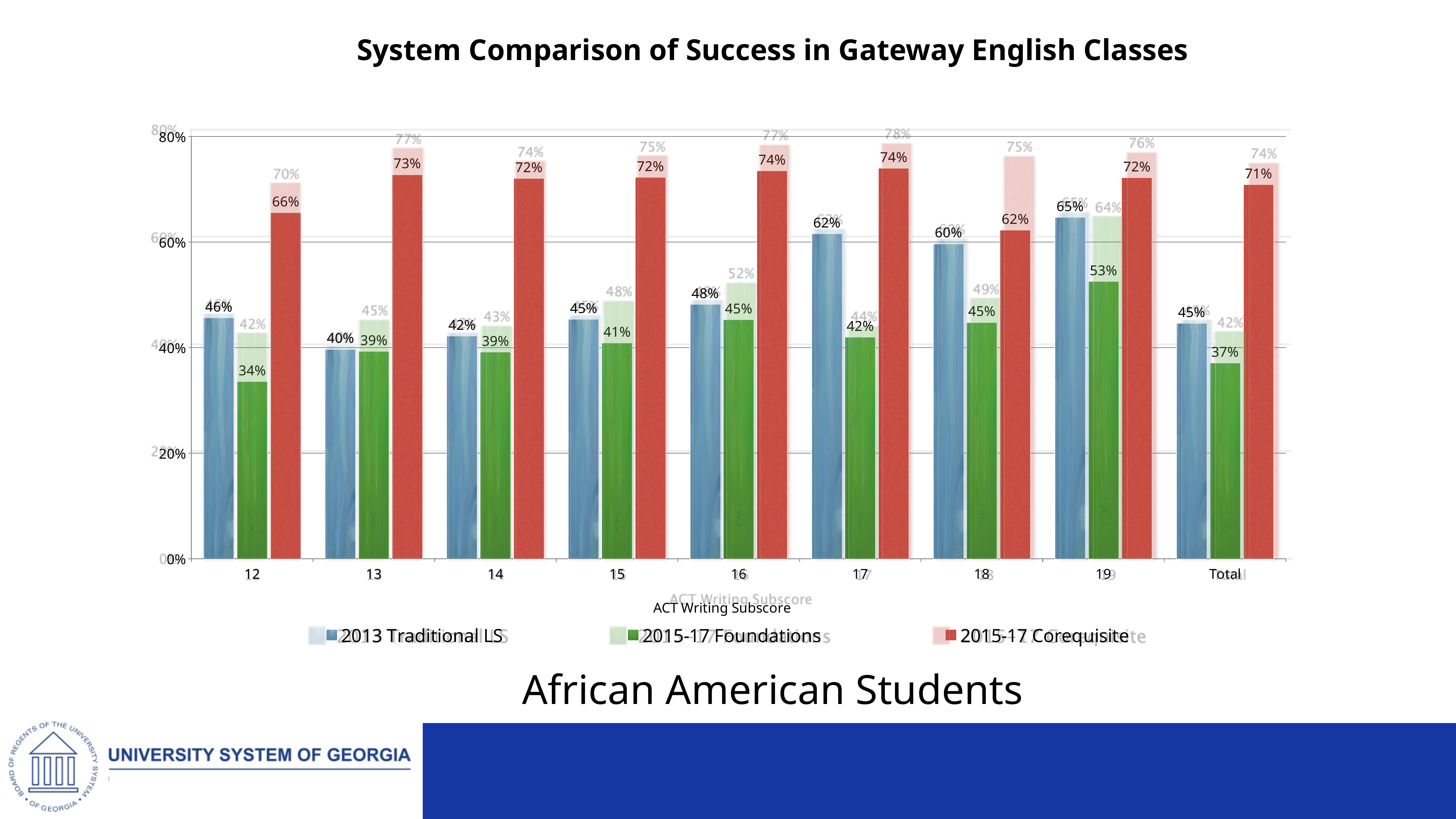
Is the value for 2015-17 Corequisite at ACT Writing Subscore 13 greater or less than 60%? greater What is the value for 2015-17 Corequisite at ACT Writing Subscore 12? 66% Which ACT Writing Subscore category has the lowest value for 2015-17 Foundations? 12 How many categories are shown on the x axis? 9 In the Total category, what is the difference between the 2015-17 Corequisite value and the 2015-17 Foundations value? 34 percentage points What is the value for 2015-17 Corequisite at ACT Writing Subscore 16? 74% Which ACT Writing Subscore category has the highest value for 2013 Traditional LS? 19 What kind of chart is shown on the slide? bar chart What is the value for 2015-17 Foundations at ACT Writing Subscore 19? 53% What is the value for 2013 Traditional LS in the Total category? 45% How many series does the legend list? 3 At ACT Writing Subscore 17, which is larger: 2013 Traditional LS or 2015-17 Foundations? 2013 Traditional LS